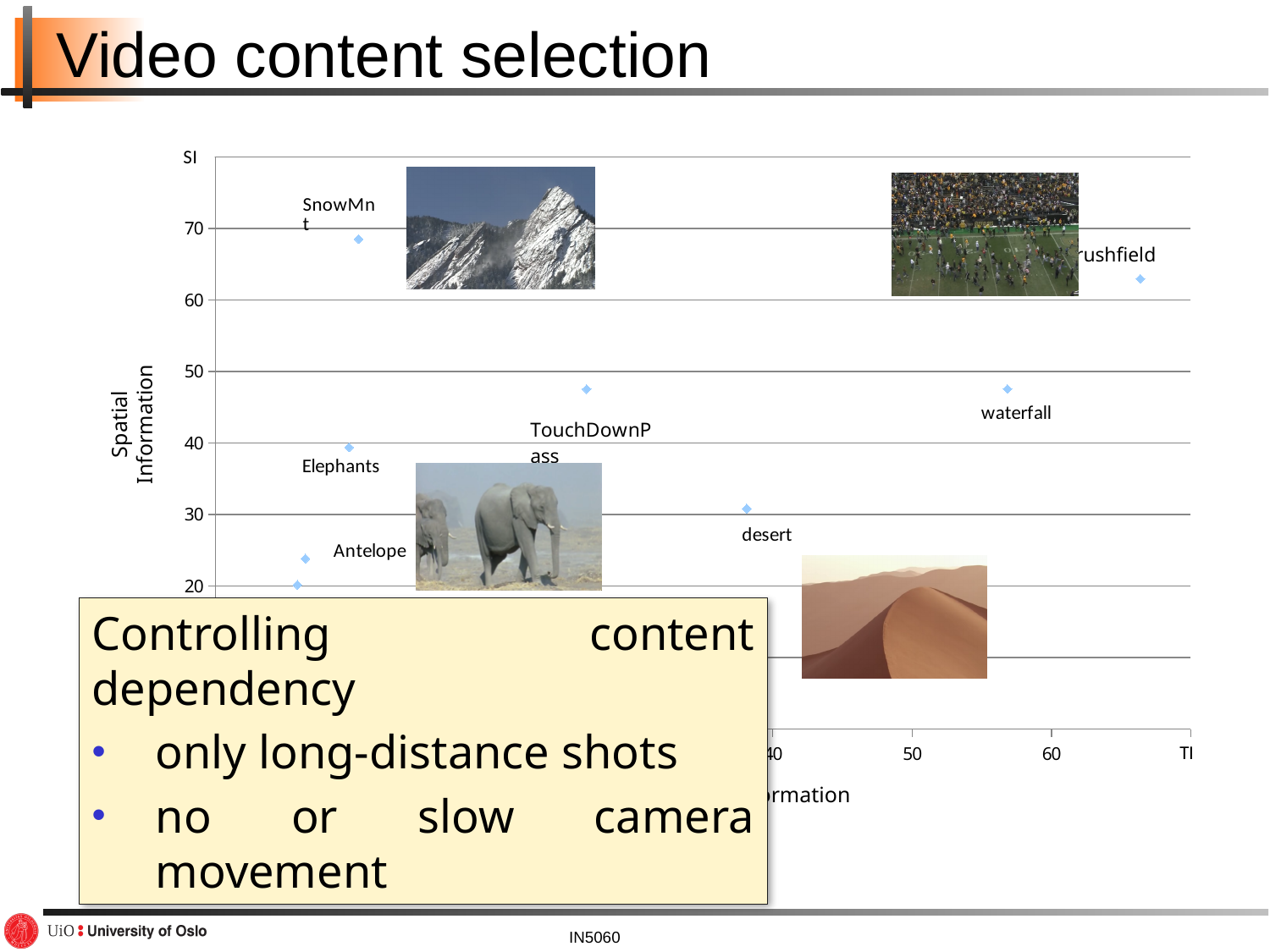
Is the SI value for SnowMnt greater or less than 60? greater Which labeled video clip has the highest Spatial Information (SI) value? SnowMnt Is the SI value for rushfield greater or less than 70? less Which has the higher SI value, Elephants or Antelope? Elephants Is the SI value for rushfield greater or less than 60? greater What is the label on the vertical axis of the chart? Spatial Information Which has the higher SI value, SnowMnt or rushfield? SnowMnt What kind of chart is shown on the slide? scatter chart Which has the higher SI value, waterfall or desert? waterfall